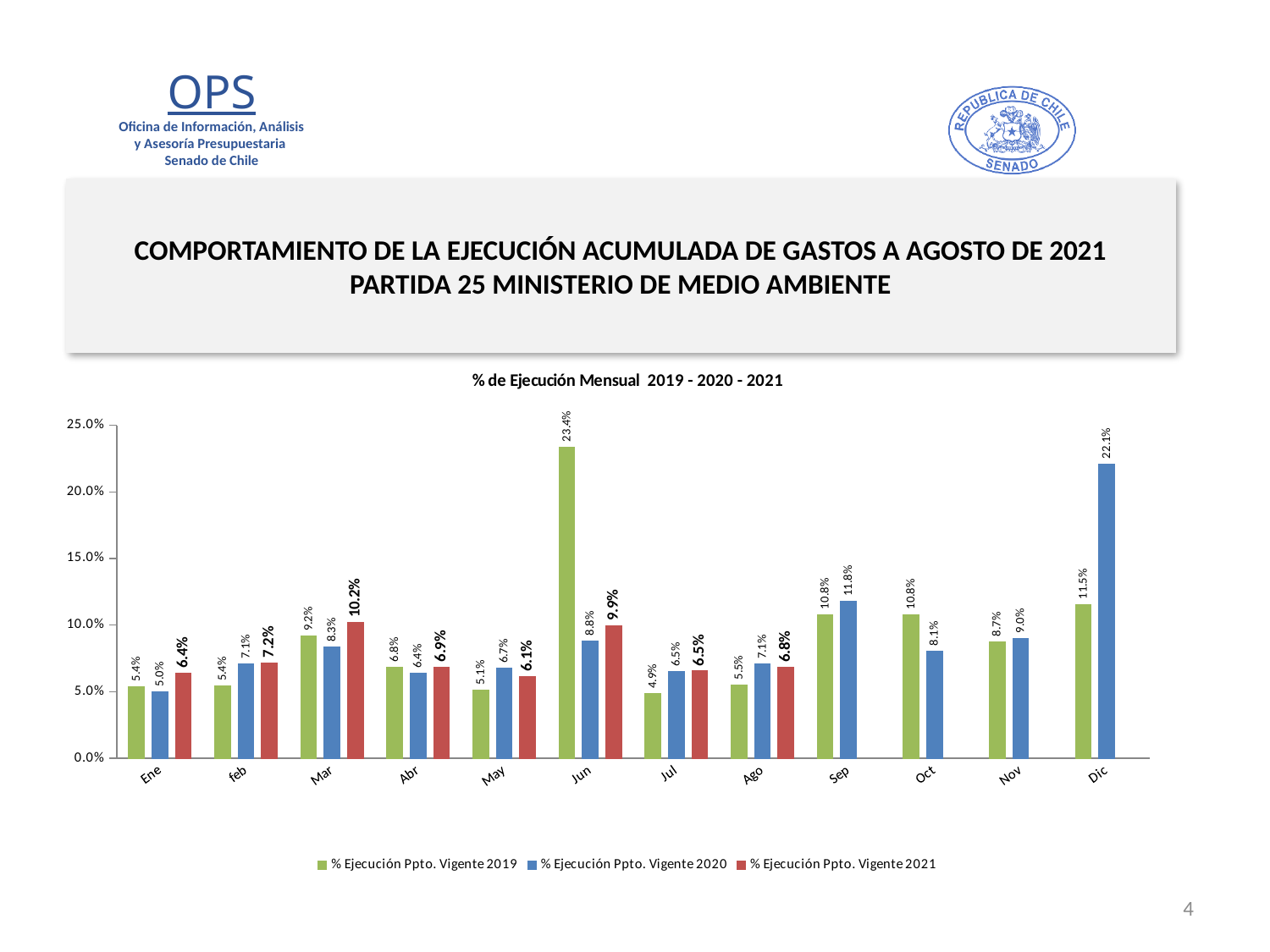
In which month is the % Ejecución Ppto. Vigente 2019 series lowest? Jul In which month is the % Ejecución Ppto. Vigente 2019 series highest? Jun How many months are shown on the x axis? 12 How many series does the legend list? 3 In which month is the % Ejecución Ppto. Vigente 2021 series highest? Mar What is the difference between the 2019 and 2020 values in Jun? 14.6% What is the value for % Ejecución Ppto. Vigente 2021 in Ago? 6.8% Which is larger in Sep: the 2019 value or the 2020 value? 2020 value (11.8%) What is the value for % Ejecución Ppto. Vigente 2019 in Jun? 23.4% What is the value for % Ejecución Ppto. Vigente 2020 in Dic? 22.1% What kind of chart is shown on the slide? Bar chart What is the value for % Ejecución Ppto. Vigente 2021 in Mar? 10.2%